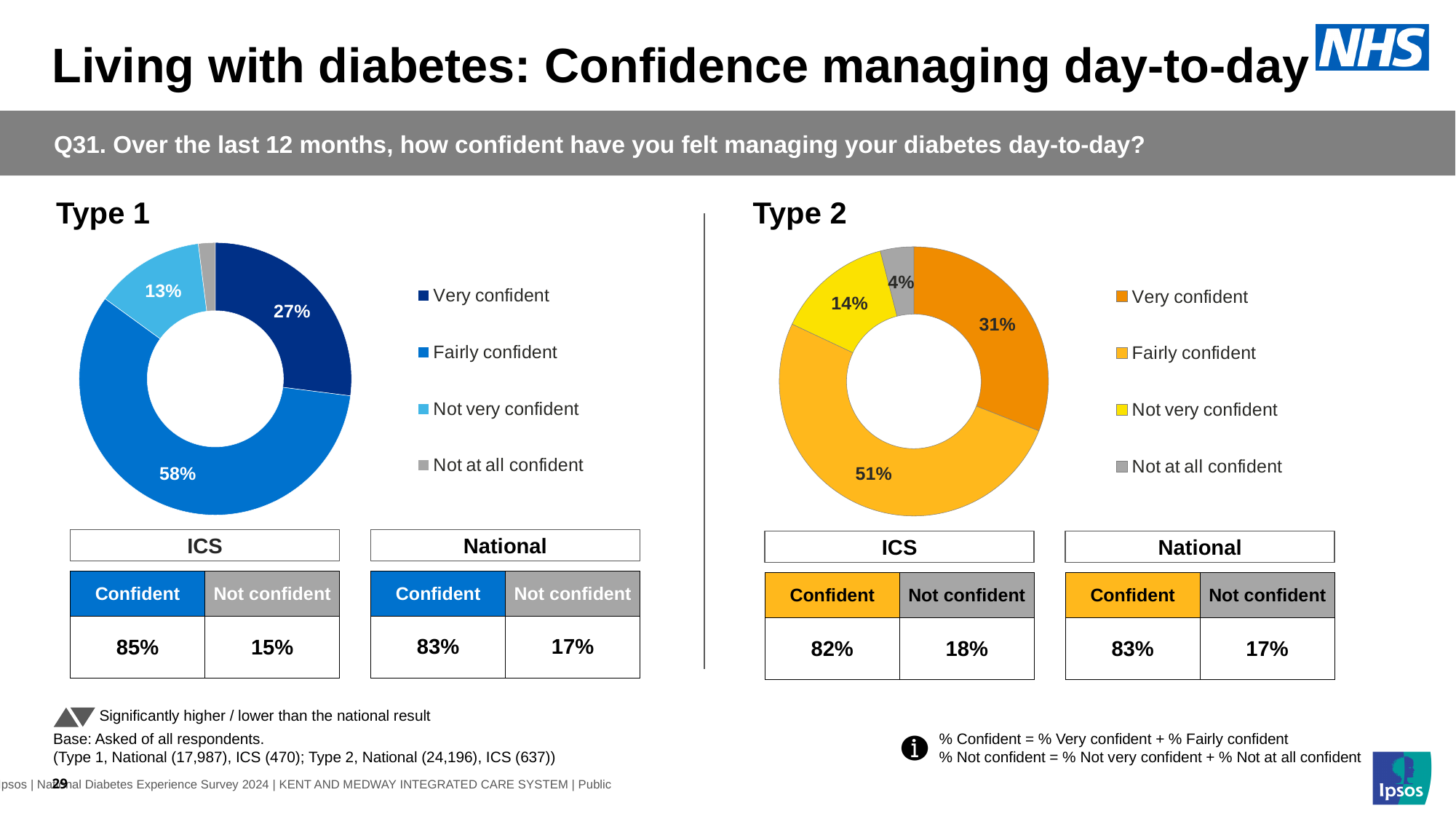
In the Type 1 chart, what percentage of respondents were very confident? 27% In the Type 2 chart, which category has the largest share? Fairly confident Which is larger: the very confident share in the Type 1 chart or in the Type 2 chart? Type 2 In the Type 1 chart, which labelled category has the smallest share? Not very confident In the Type 1 chart, what is the difference between the fairly confident and very confident shares? 31 percentage points In the Type 2 chart, what colour is the Not very confident slice? Yellow In the Type 2 chart, what is the difference between the fairly confident and very confident shares? 20 percentage points In the Type 1 chart, what percentage of respondents were fairly confident? 58% What kind of chart is used for Type 1? Donut (pie) chart How many entries does the legend of the Type 2 chart list? 4 In the Type 2 chart, what percentage of respondents were not very confident? 14% In the Type 2 chart, what percentage of respondents were not at all confident? 4%